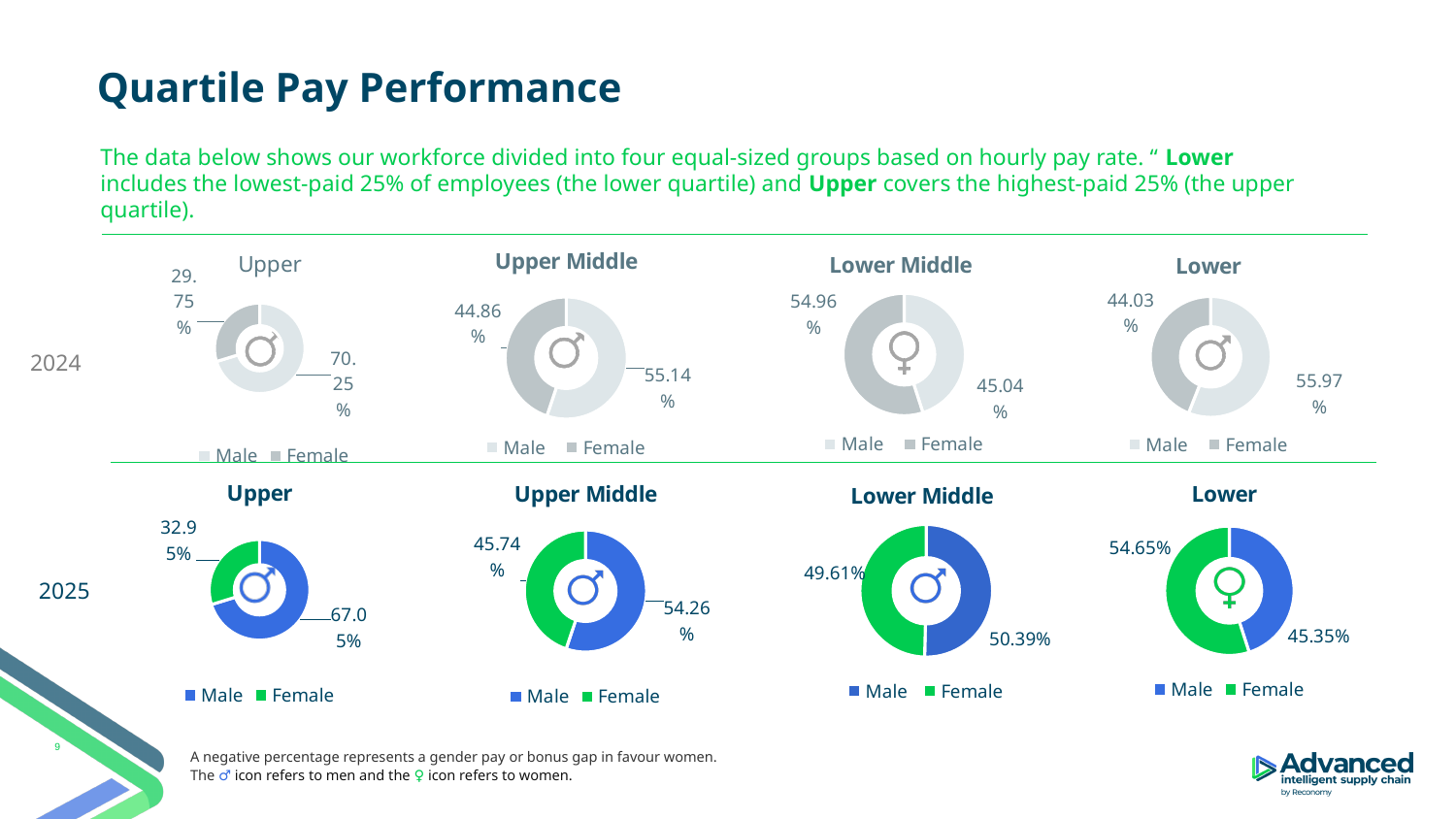
In the 2025 Upper chart, what is the difference between the Male and Female values? 34.10% What kind of chart is used for the 2024 Upper Middle quartile? Donut chart In the 2025 Lower chart, what is the value for Female? 54.65% How many series does the legend of the 2025 Lower Middle chart list? 2 In the 2024 Lower Middle chart, what are the two values shown? 54.96% and 45.04% In the 2025 Upper chart, what is the value for Female? 32.95% In the 2025 Upper Middle chart, what is the value for Female? 45.74% In the 2025 Lower chart, what is the value for Male? 45.35% In the 2025 charts, what colour represents Male? Blue In the 2025 Upper chart, what is the value for Male? 67.05% In the 2025 Lower chart, which is larger, Male or Female? Female In the 2025 Upper Middle chart, which is larger, Male or Female? Male